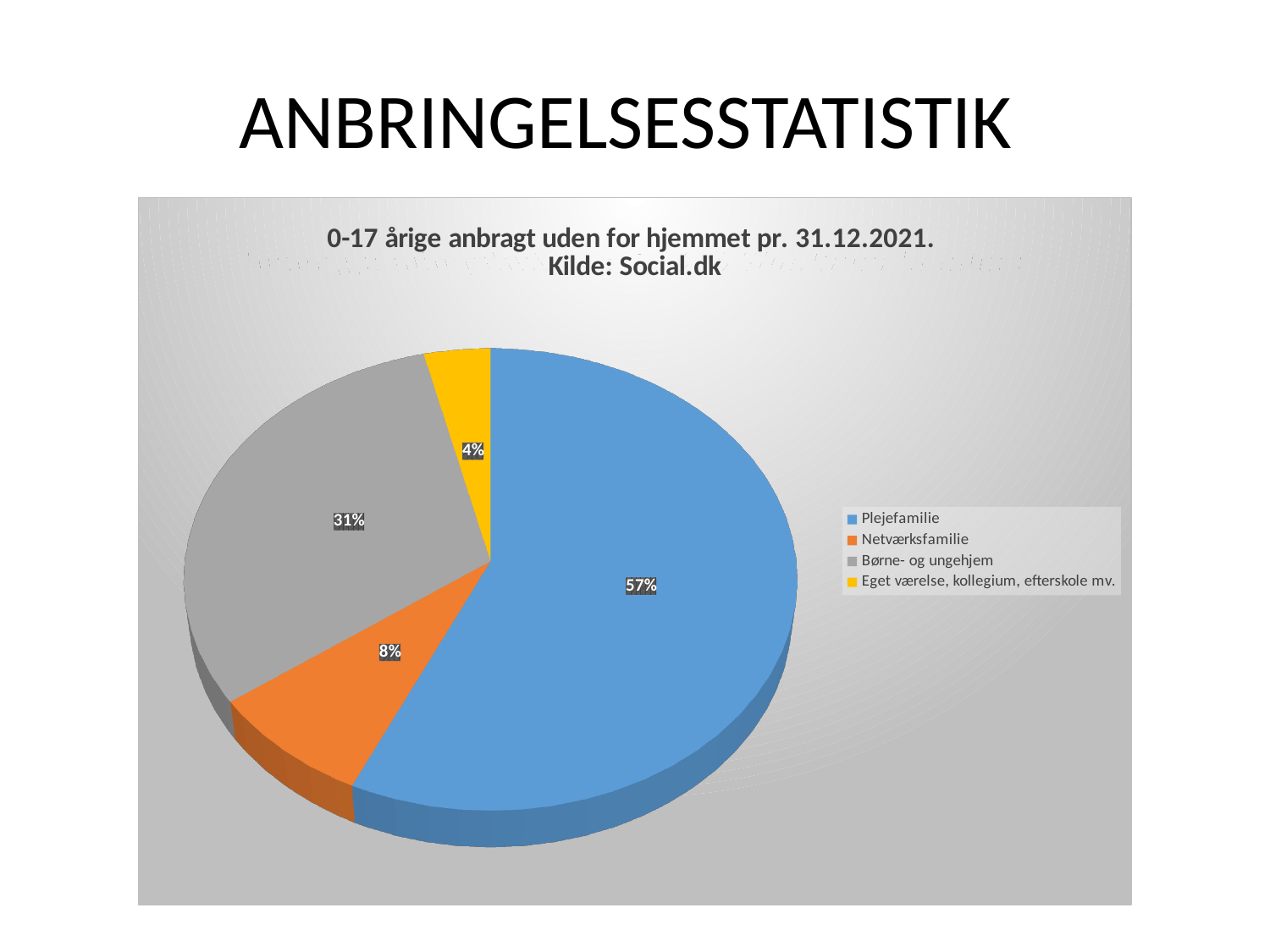
What share of the pie does Plejefamilie represent? 57% What kind of chart is shown on the slide? Pie chart How many categories does the pie chart show? 4 What share of the pie does Børne- og ungehjem represent? 31% Which category has the largest slice of the pie? Plejefamilie What share of the pie does Netværksfamilie represent? 8% Which is larger, the share for Netværksfamilie or the share for Børne- og ungehjem? Børne- og ungehjem What is the title of the chart? 0-17 årige anbragt uden for hjemmet pr. 31.12.2021. Kilde: Social.dk Which category has the smallest slice of the pie? Eget værelse, kollegium, efterskole mv. What is the difference in percentage points between Plejefamilie and Børne- og ungehjem? 26 percentage points Which colour represents Netværksfamilie in the pie chart? Orange